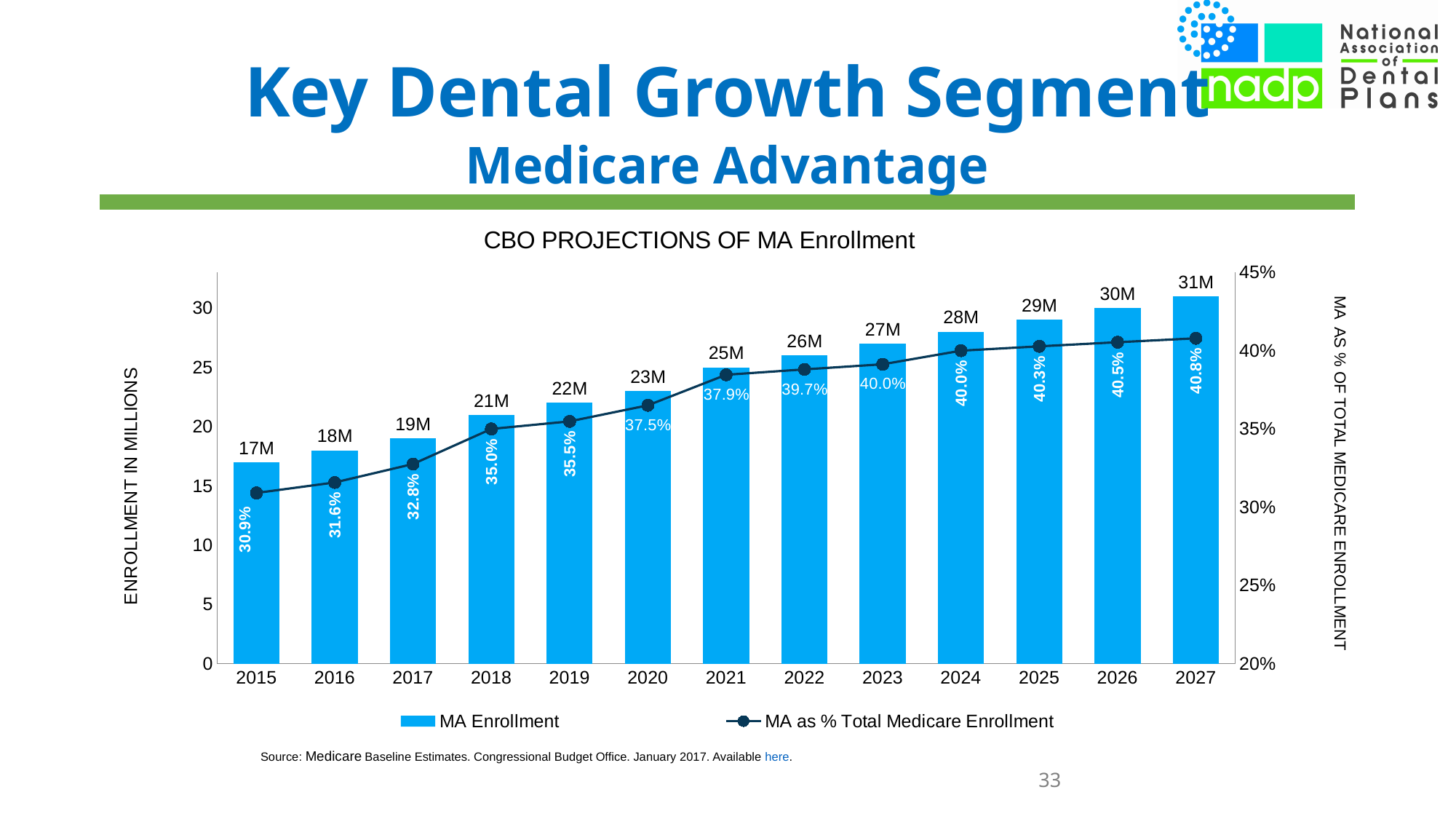
Which year has the highest MA Enrollment? 2027 Does MA Enrollment rise or fall from 2015 to 2027? rise What is the difference in MA as % Total Medicare Enrollment between 2021 and 2020? 0.4% What is the MA Enrollment value for 2020? 23M What is the difference in MA Enrollment between 2027 and 2015? 14M What is the MA as % Total Medicare Enrollment value for 2027? 40.8% What is the MA as % Total Medicare Enrollment value for 2017? 32.8% How many series does the legend list? 2 What is the title of the chart? CBO PROJECTIONS OF MA Enrollment Which year has the lowest MA as % Total Medicare Enrollment? 2015 How many years are shown on the x axis? 13 Which year has a higher MA Enrollment, 2018 or 2024? 2024